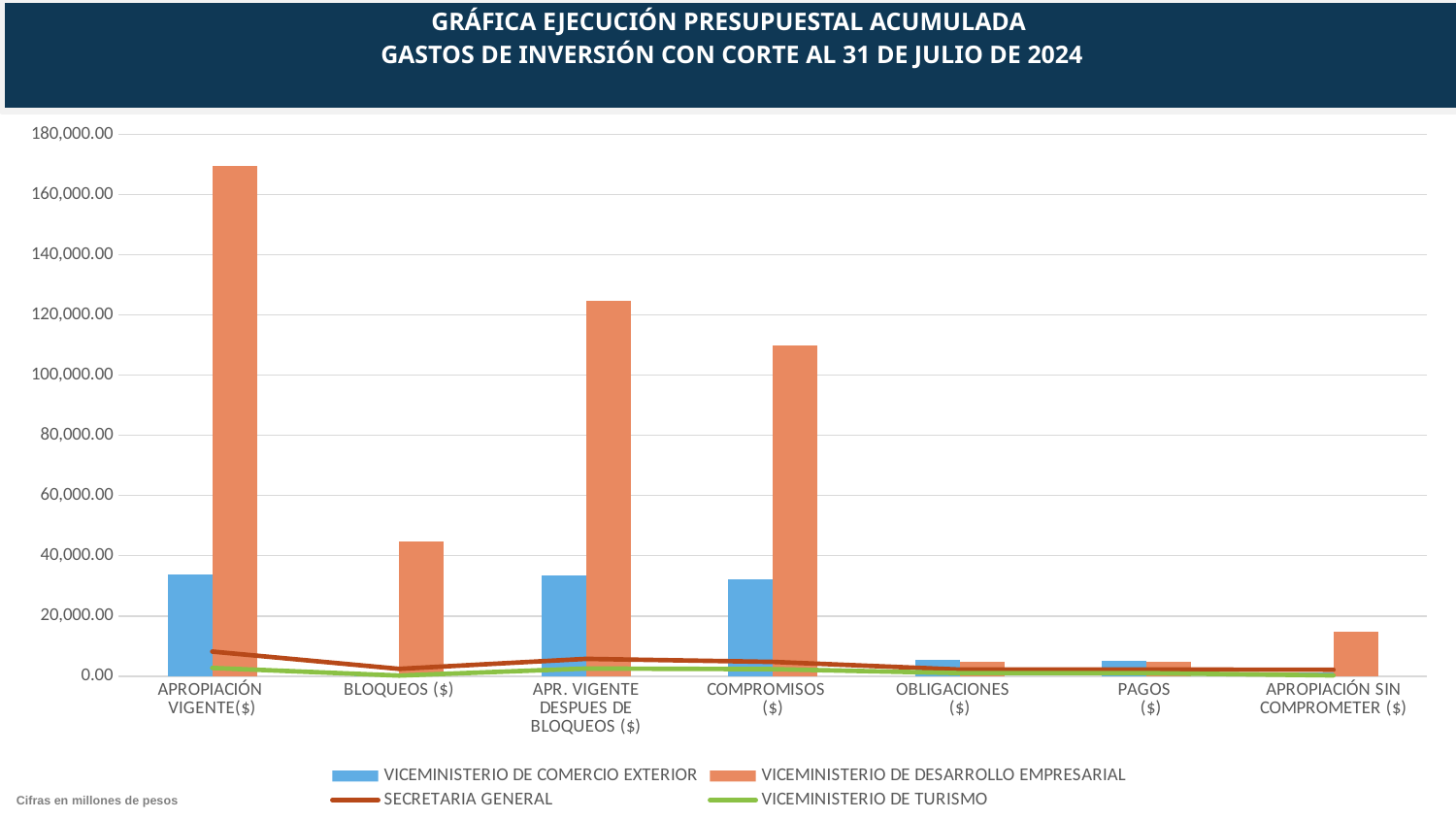
Which series is plotted as a dark red line? SECRETARIA GENERAL How many series does the legend list? 4 Is the value for VICEMINISTERIO DE DESARROLLO EMPRESARIAL at BLOQUEOS ($) greater or less than 40,000.00? greater Is the value for VICEMINISTERIO DE COMERCIO EXTERIOR at APROPIACIÓN VIGENTE($) greater or less than 40,000.00? less At COMPROMISOS ($), which is larger: VICEMINISTERIO DE COMERCIO EXTERIOR or VICEMINISTERIO DE DESARROLLO EMPRESARIAL? VICEMINISTERIO DE DESARROLLO EMPRESARIAL According to the note on the slide, in what units are the figures expressed? Millones de pesos Is the value for VICEMINISTERIO DE DESARROLLO EMPRESARIAL at APROPIACIÓN VIGENTE($) greater or less than 160,000.00? greater For VICEMINISTERIO DE DESARROLLO EMPRESARIAL, which category has the highest value? APROPIACIÓN VIGENTE($) How many categories are shown along the x axis? 7 What kind of chart is shown on the slide? A combined bar and line chart